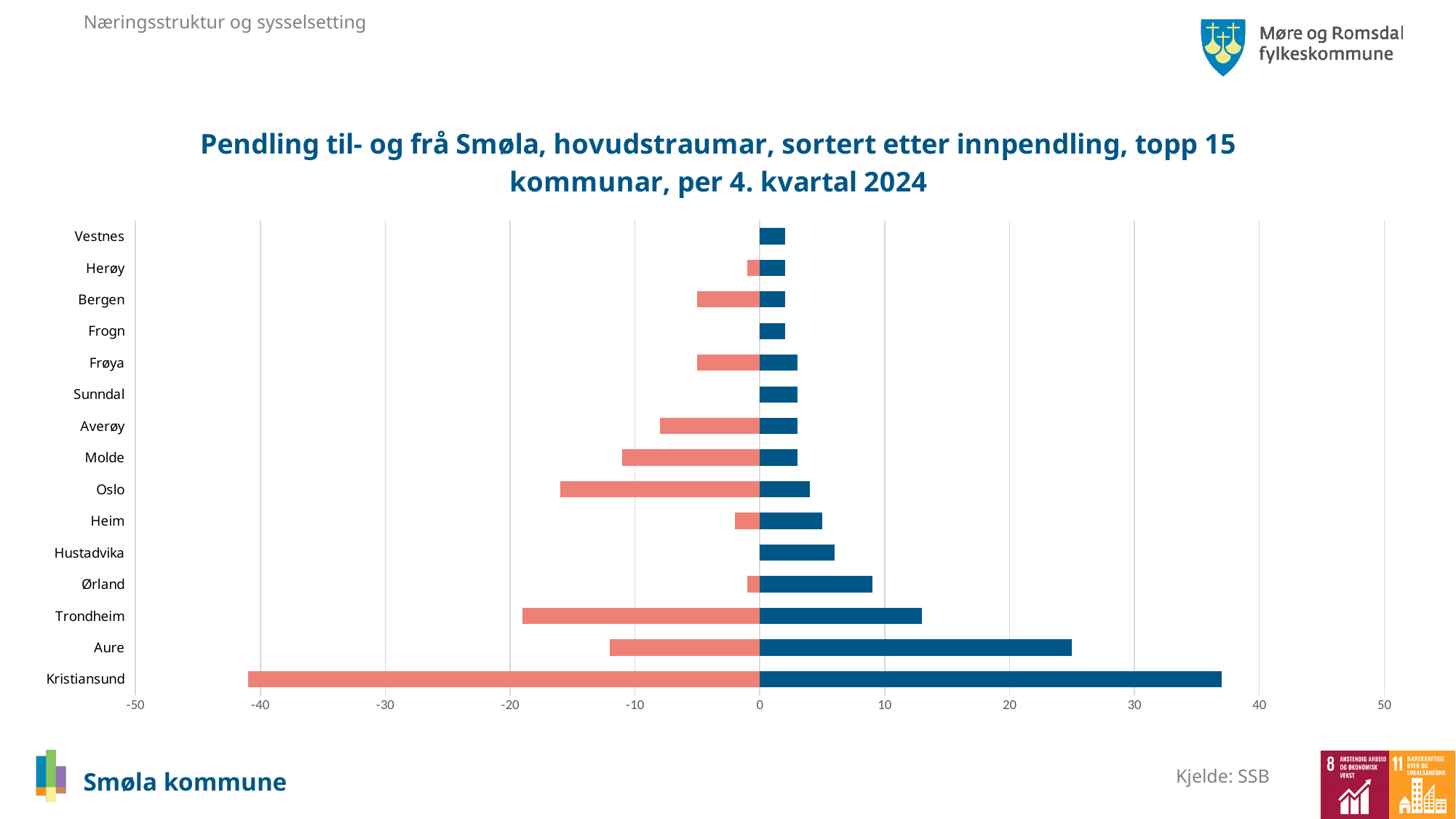
How many municipalities are listed on the vertical axis of the chart? 15 What kind of chart is shown on the slide? bar chart Is the blue bar for Aure greater or less than 20? greater Which has the longer blue bar, Aure or Trondheim? Aure Which municipality has the longest blue bar in the chart? Kristiansund Is the blue bar for Kristiansund greater or less than 30? greater Is the red bar for Oslo greater or less than -10? less Which has the longer red bar, Oslo or Molde? Oslo Which municipality has the longest red bar (extending furthest to the left) in the chart? Kristiansund What is the source cited for the chart data? SSB